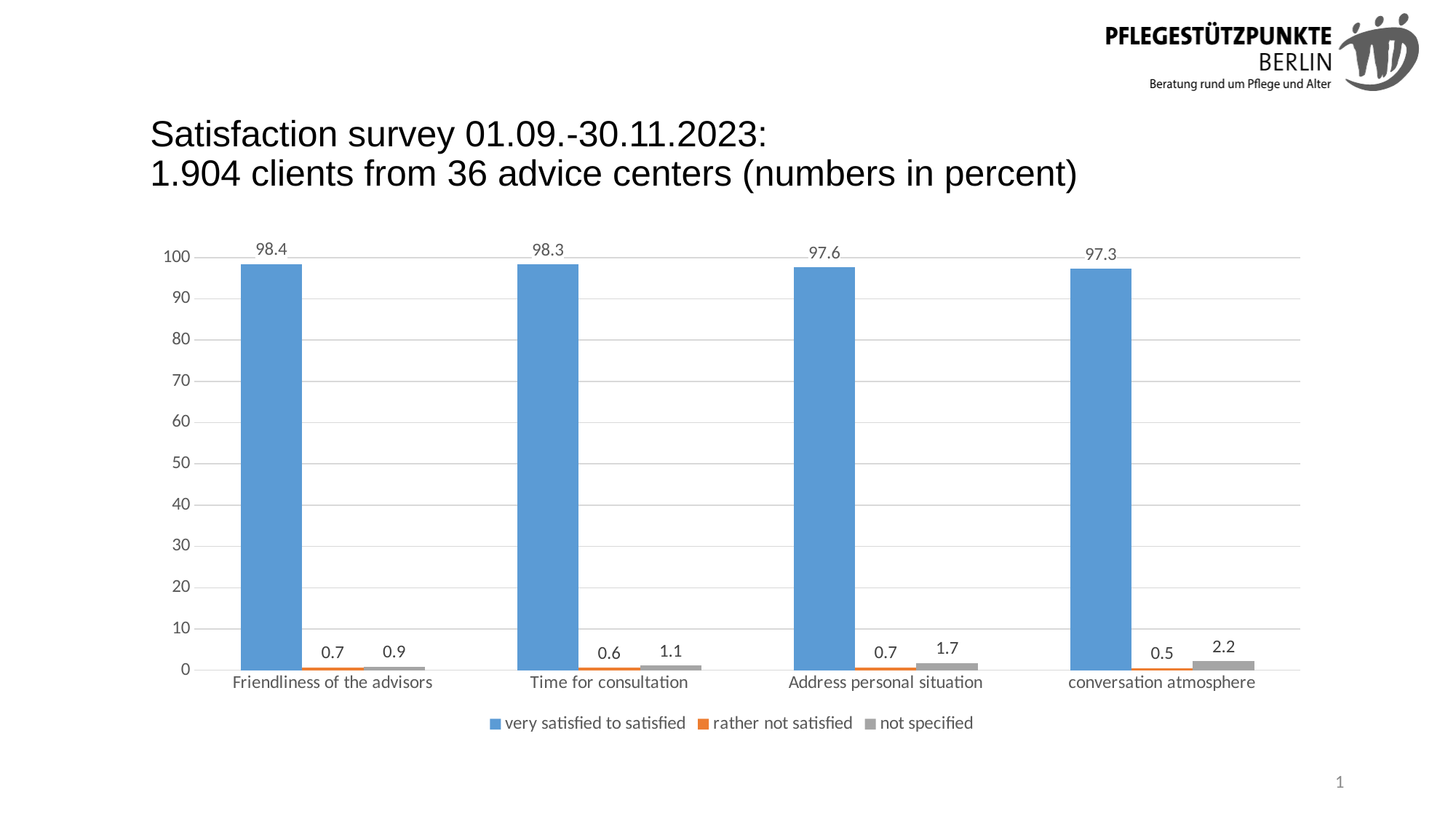
Which colour represents the 'rather not satisfied' series? Orange How many series does the legend list? 3 What kind of chart is shown on the slide? Bar chart What is the value for 'very satisfied to satisfied' for Friendliness of the advisors? 98.4 Do the 'very satisfied to satisfied' values rise or fall from left to right along the x axis? Fall Which category has the lowest 'not specified' value? Friendliness of the advisors Which is larger: the 'not specified' value for Address personal situation or for Time for consultation? Address personal situation Which category has the highest 'very satisfied to satisfied' value? Friendliness of the advisors What is the value for 'not specified' for conversation atmosphere? 2.2 How many categories are shown on the x axis? 4 What is the difference between the 'very satisfied to satisfied' values for Friendliness of the advisors and conversation atmosphere? 1.1 What is the value for 'rather not satisfied' for Time for consultation? 0.6